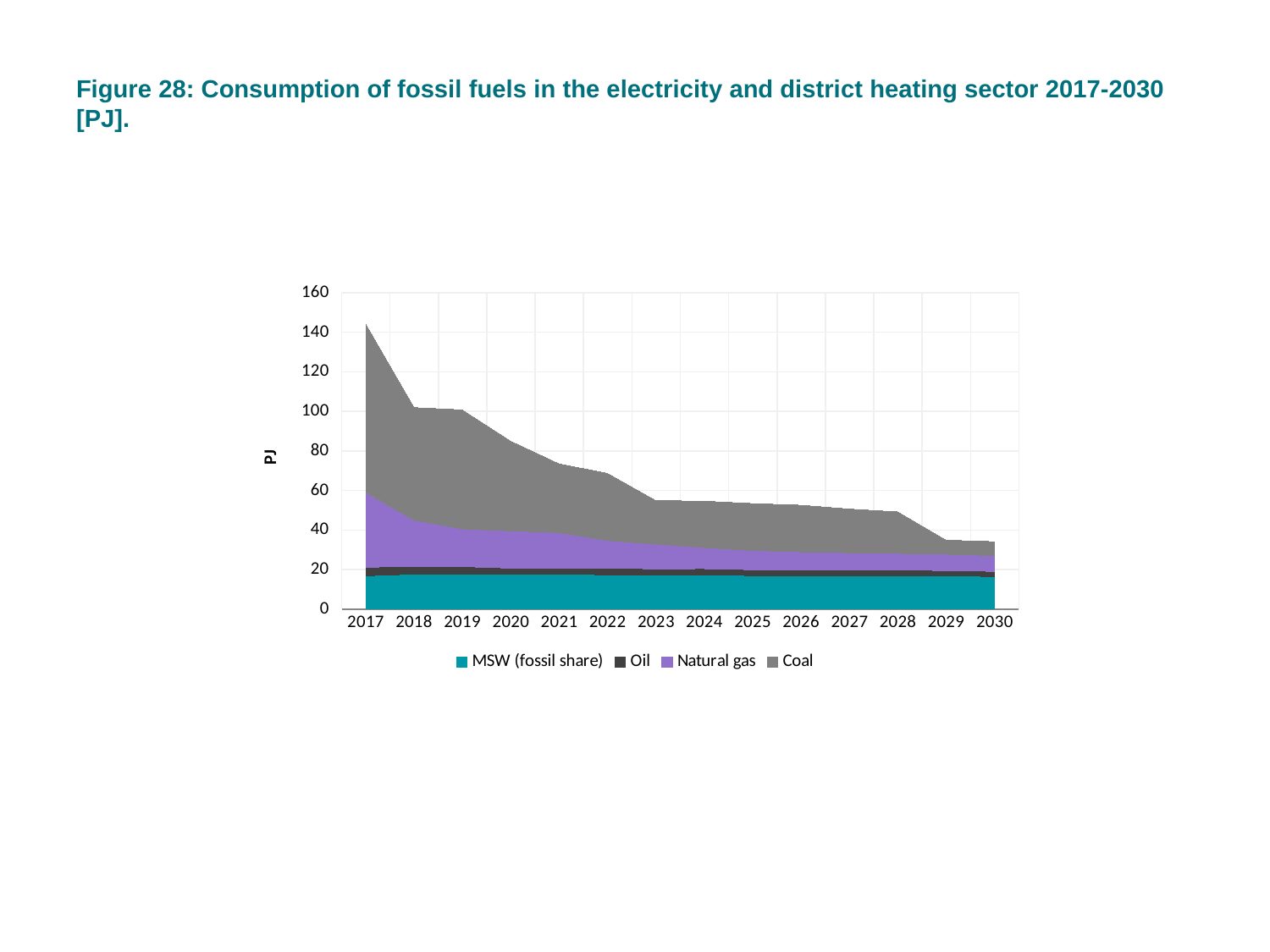
Which series is shown in purple in the legend? Natural gas What unit is shown on the y axis label? PJ How many years are shown along the x axis? 14 Which year has the highest total fossil fuel consumption? 2017 Which year has the lowest total fossil fuel consumption? 2030 Does total fossil fuel consumption rise or fall from 2017 to 2030? Fall Is the total consumption in 2017 greater or less than 120 PJ? greater Is the total consumption in 2020 greater or less than 100 PJ? less Is the total consumption in 2030 greater or less than 40 PJ? less Which is larger, the total consumption in 2017 or in 2030? 2017 How many series does the legend list? 4 What kind of chart is shown on the slide? Stacked area chart